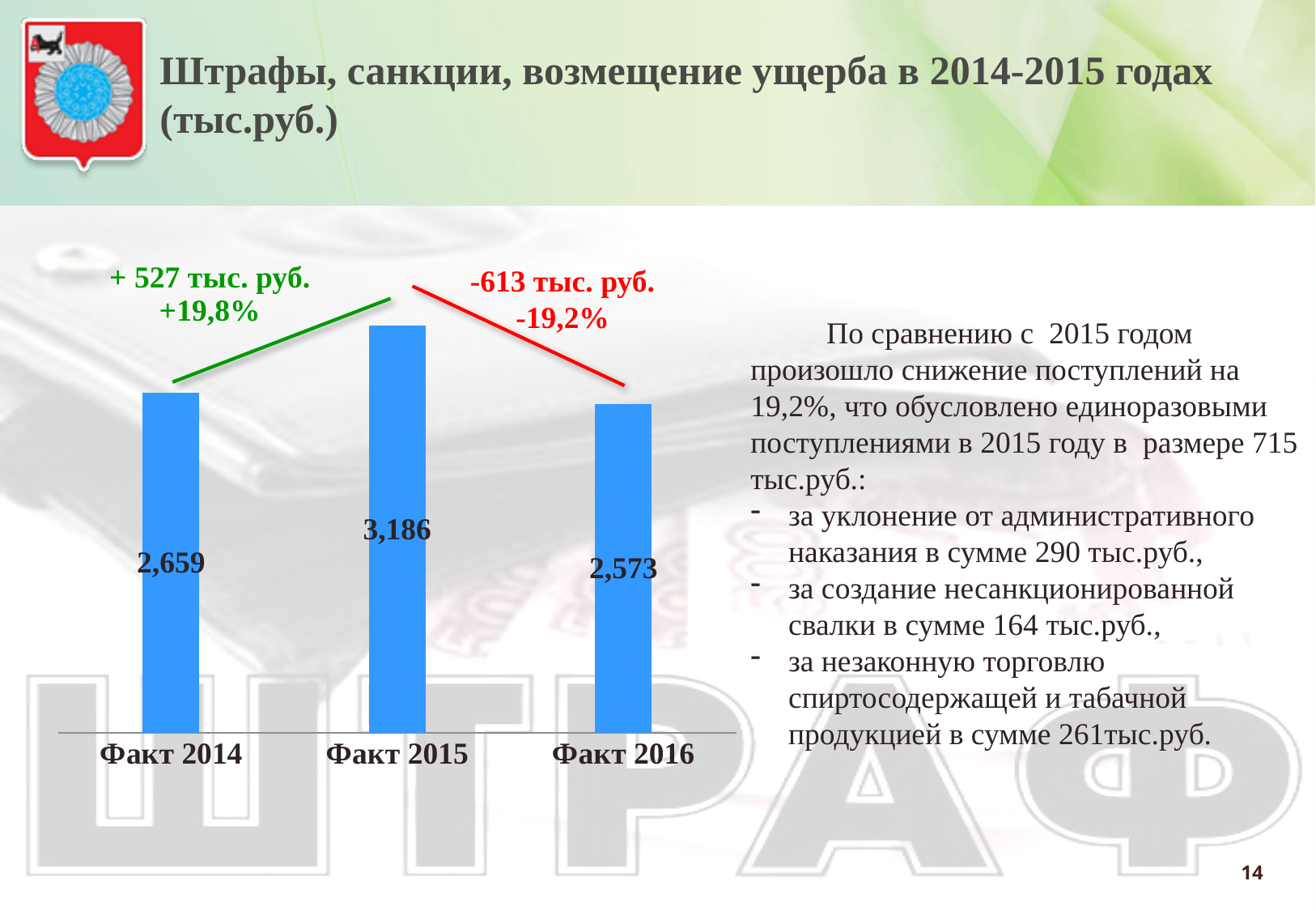
Does the value rise or fall from Факт 2015 to Факт 2016? Fall Which is larger, the value for Факт 2014 or the value for Факт 2016? Факт 2014 What is the value for Факт 2014? 2,659 Which category has the highest value? Факт 2015 Which category has the lowest value? Факт 2016 What kind of chart is shown on the slide? Bar chart What is the value for Факт 2016? 2,573 What is the value for Факт 2015? 3,186 What percentage change is annotated between Факт 2015 and Факт 2016? -19,2% What is the difference between the values for Факт 2015 and Факт 2016? 613 How many categories are shown in the chart? 3 What is the difference between the values for Факт 2015 and Факт 2014? 527